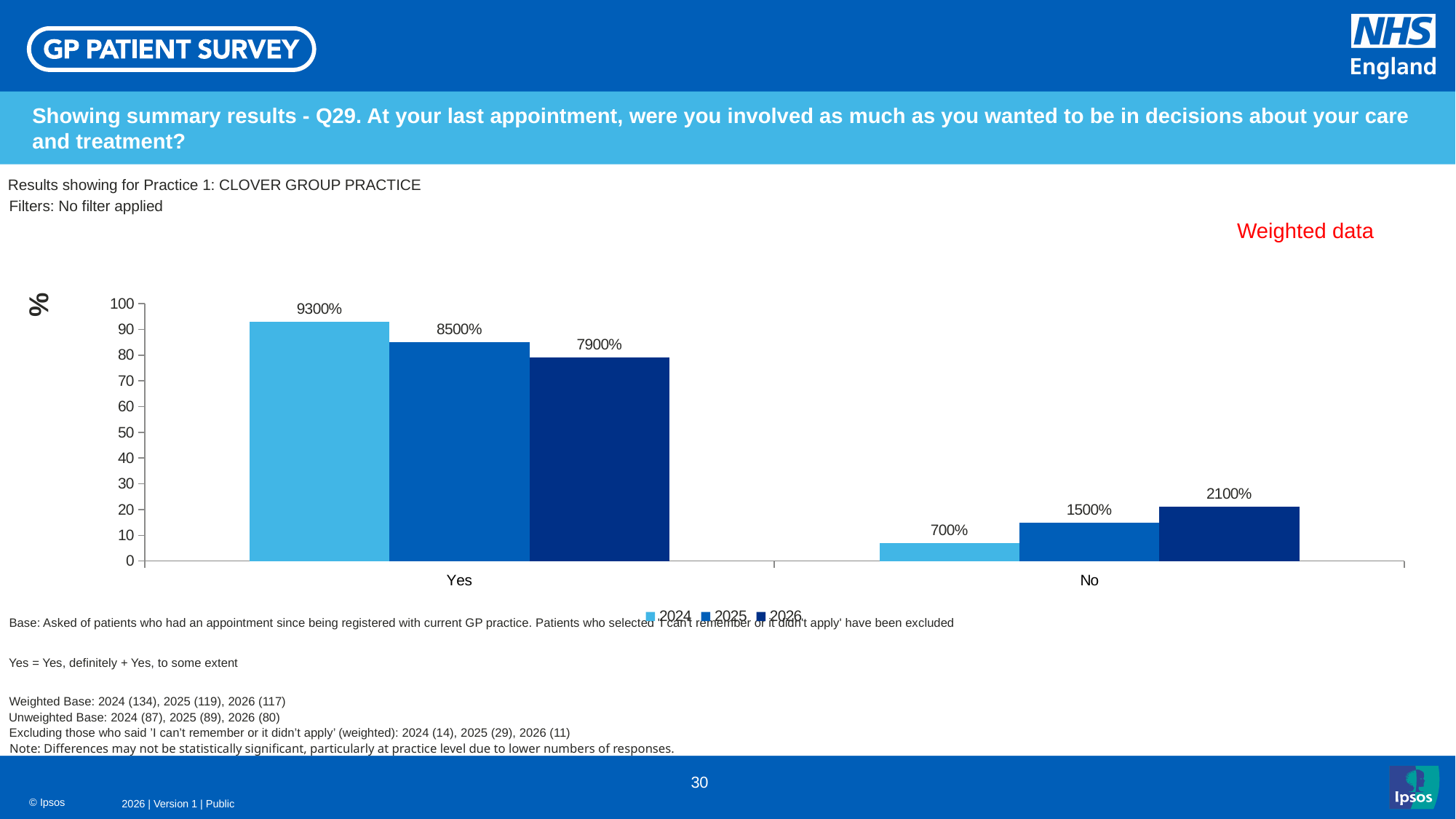
How many categories are shown on the x axis? 2 What is the data label shown for 2024 in the Yes category? 9300% What is the data label shown for 2025 in the Yes category? 8500% Which year has the lowest bar in the No category? 2024 Which is larger in the No category, the 2025 bar or the 2026 bar? 2026 What is the data label shown for 2024 in the No category? 700% Do the bars in the Yes category rise or fall from 2024 to 2026? fall What is the data label shown for 2026 in the No category? 2100% Is the 2026 bar in the Yes category greater or less than 70 on the axis? greater What type of chart is shown on the slide? bar chart Which year has the highest bar in the Yes category? 2024 How many series does the legend list? 3